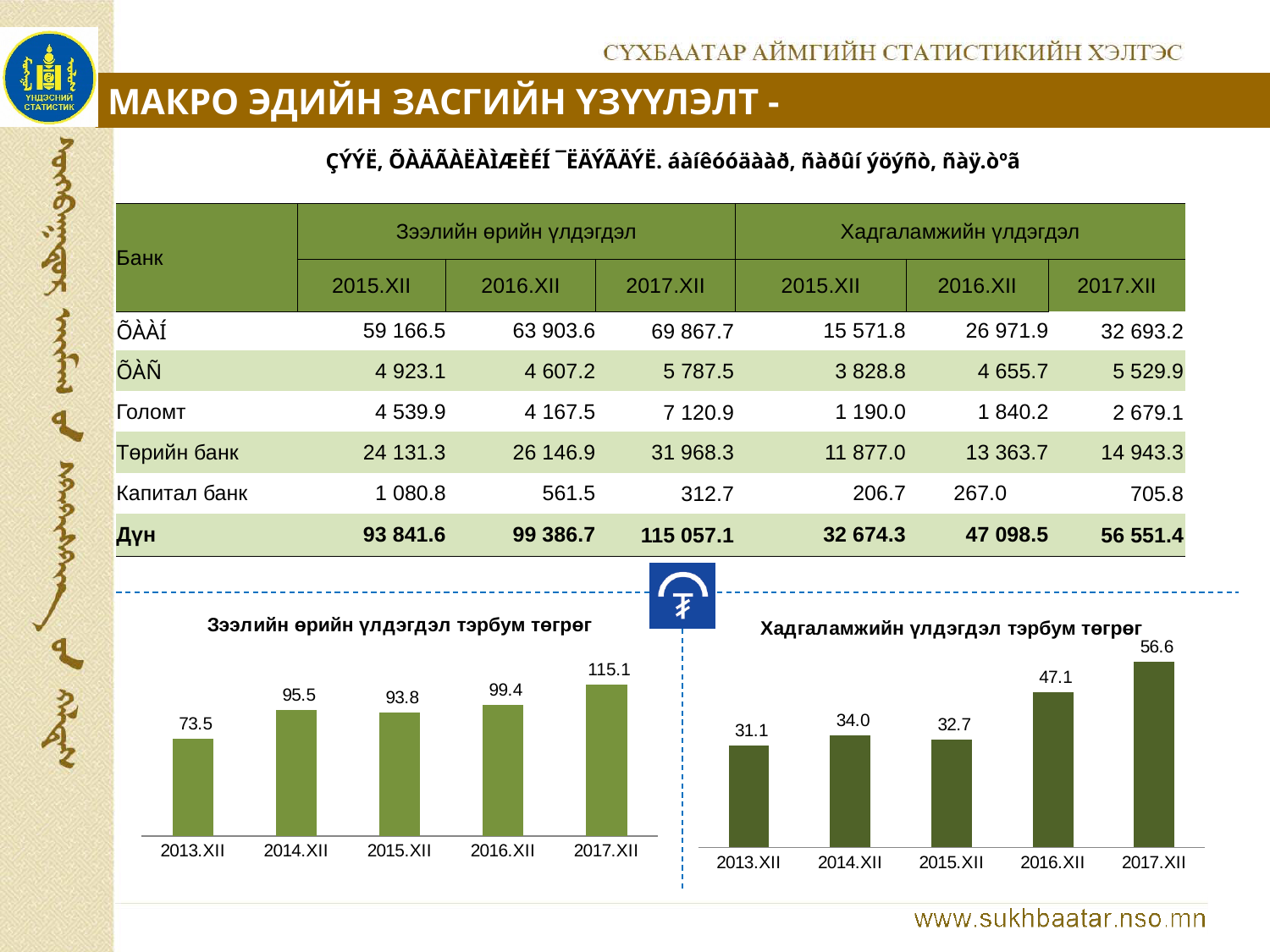
How many bars are shown in the right chart titled 'Хадгаламжийн үлдэгдэл тэрбум төгрөг'? 5 In the left chart titled 'Зээлийн өрийн үлдэгдэл тэрбум төгрөг', which is larger: the value for 2014.XII or 2015.XII? 2014.XII In the right chart titled 'Хадгаламжийн үлдэгдэл тэрбум төгрөг', what is the difference between the values for 2017.XII and 2016.XII? 9.5 In the left chart titled 'Зээлийн өрийн үлдэгдэл тэрбум төгрөг', what is the value for 2013.XII? 73.5 In the left chart titled 'Зээлийн өрийн үлдэгдэл тэрбум төгрөг', what is the value for 2017.XII? 115.1 In the right chart titled 'Хадгаламжийн үлдэгдэл тэрбум төгрөг', which is larger: the value for 2014.XII or 2015.XII? 2014.XII In the left chart titled 'Зээлийн өрийн үлдэгдэл тэрбум төгрөг', which year has the highest value? 2017.XII In the left chart titled 'Зээлийн өрийн үлдэгдэл тэрбум төгрөг', what is the difference between the values for 2017.XII and 2013.XII? 41.6 What type of chart is the left chart titled 'Зээлийн өрийн үлдэгдэл тэрбум төгрөг'? Bar chart In the right chart titled 'Хадгаламжийн үлдэгдэл тэрбум төгрөг', do the values rise or fall from 2015.XII to 2017.XII? Rise In the right chart titled 'Хадгаламжийн үлдэгдэл тэрбум төгрөг', what is the value for 2016.XII? 47.1 In the right chart titled 'Хадгаламжийн үлдэгдэл тэрбум төгрөг', which year has the lowest value? 2013.XII